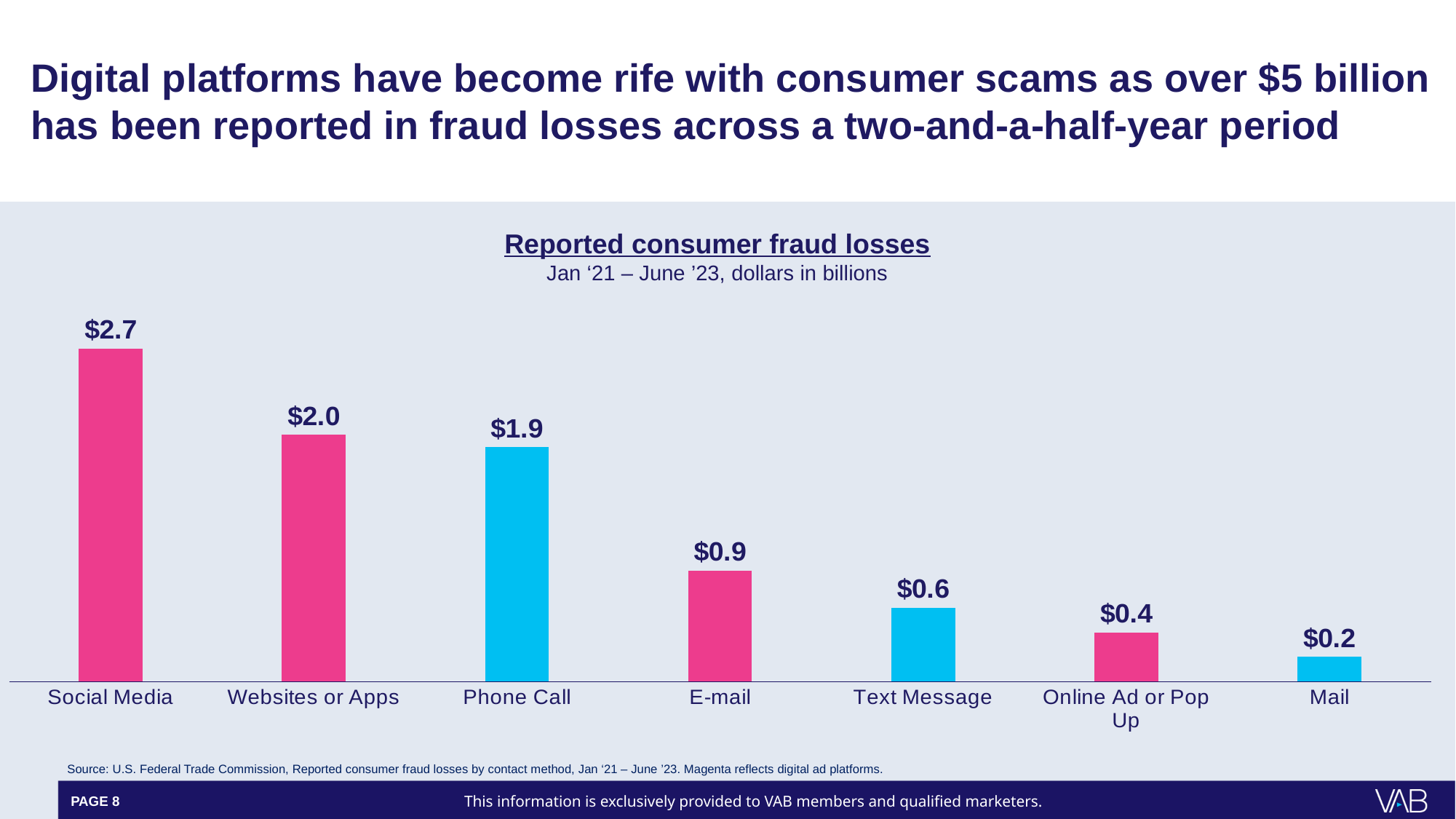
What is the reported consumer fraud loss for Social Media? $2.7 Which contact method has the highest reported fraud losses? Social Media How many contact method categories are shown in the chart? 7 What is the difference between the fraud losses for E-mail and Text Message? $0.3 What is the reported consumer fraud loss for Online Ad or Pop Up? $0.4 What is the difference between the fraud losses for Social Media and Websites or Apps? $0.7 Which has higher reported fraud losses, Text Message or Online Ad or Pop Up? Text Message What is the reported consumer fraud loss for Phone Call? $1.9 What is the title of the chart? Reported consumer fraud losses What type of chart is shown on the slide? Bar chart Which has higher reported fraud losses, Websites or Apps or Phone Call? Websites or Apps Which contact method has the lowest reported fraud losses? Mail